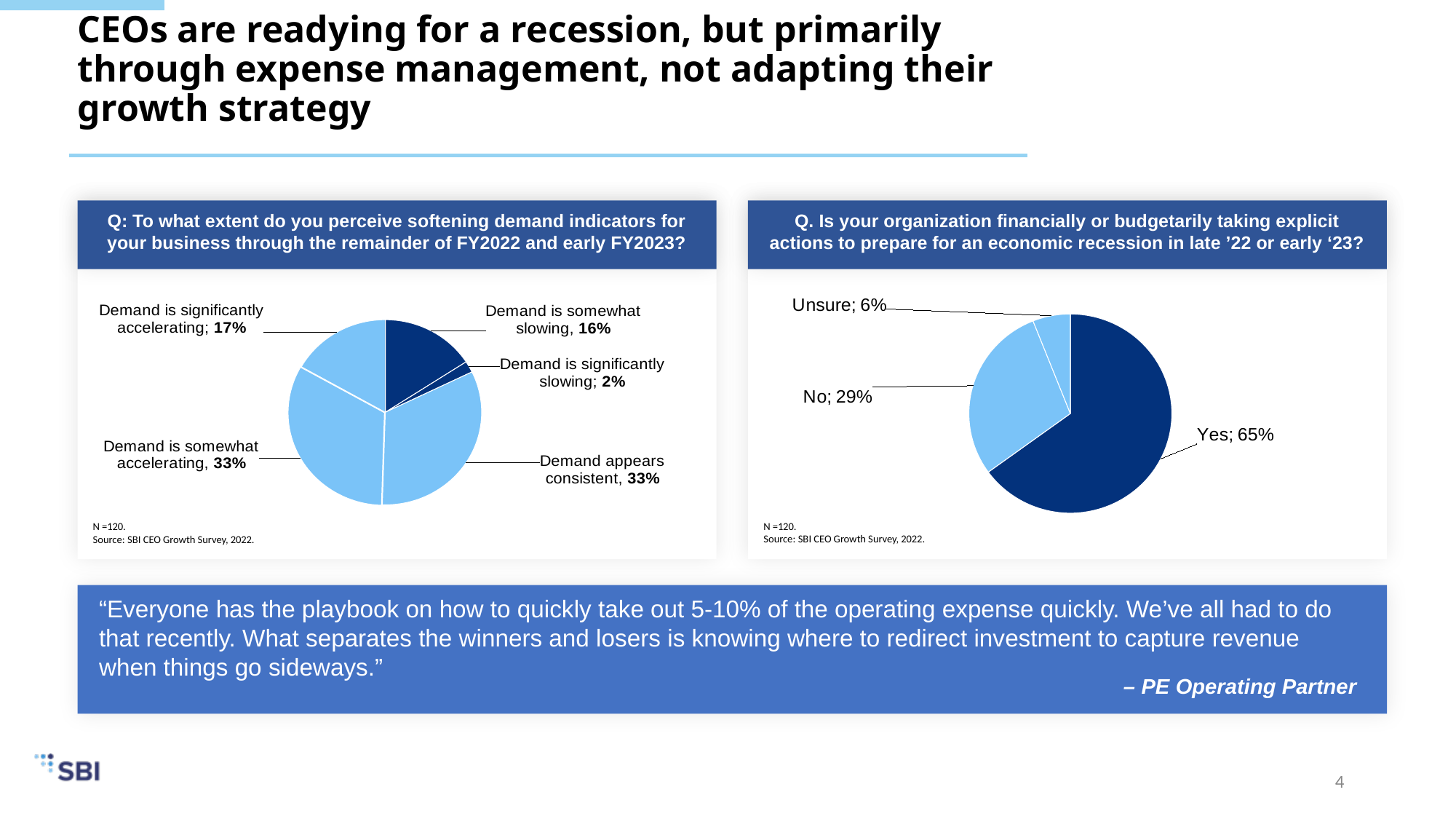
In the left pie chart about softening demand indicators, what is the difference between the share for 'Demand is somewhat accelerating' and the share for 'Demand is somewhat slowing'? 17% In the right pie chart about preparing for an economic recession, what share of respondents answered 'Yes'? 65% In the right pie chart about preparing for an economic recession, what share of respondents answered 'Unsure'? 6% In the left pie chart about softening demand indicators, what share of respondents said demand is significantly slowing? 2% In the left pie chart about softening demand indicators, how many categories are shown? 5 In the right pie chart about preparing for an economic recession, which response has the largest share? Yes In the left pie chart about softening demand indicators, which category has the smallest share? Demand is significantly slowing In the left pie chart about softening demand indicators, what share of respondents said demand is significantly accelerating? 17% In the left pie chart about softening demand indicators, which is larger: the share for 'Demand is significantly accelerating' or the share for 'Demand is somewhat slowing'? Demand is significantly accelerating What type of chart is used on the right side of the slide for the recession-preparation question? Pie chart In the right pie chart about preparing for an economic recession, what is the difference between the 'Yes' share and the 'No' share? 36% What sample size (N) is stated beneath the left pie chart? N =120